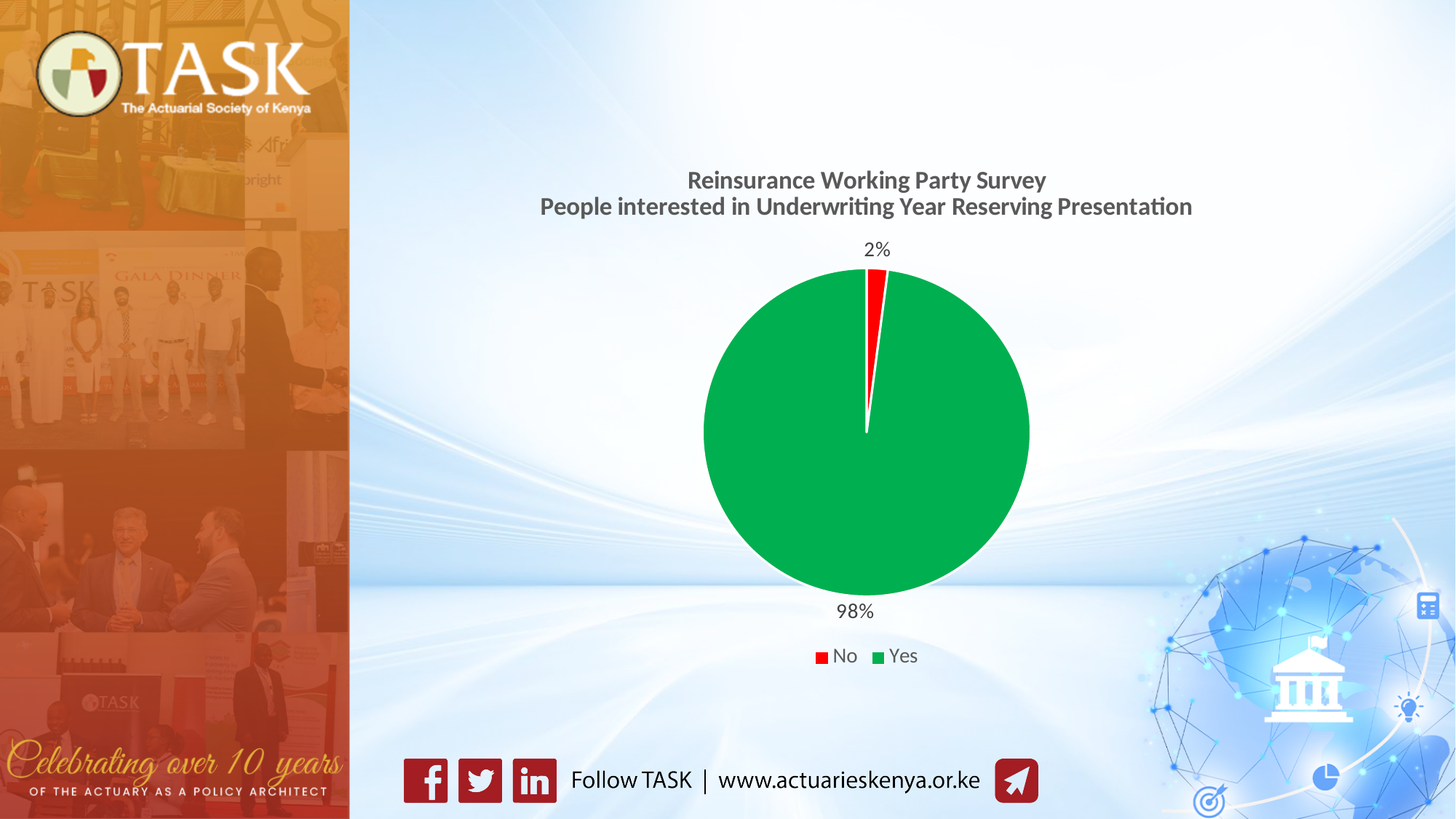
What percentage of respondents answered Yes? 98% What colour is the No slice? red What is the first line of the chart title? Reinsurance Working Party Survey Which is larger, the share for Yes or the share for No? Yes What percentage of respondents answered No? 2% Which response has the smallest share of the pie? No How many slices does the pie chart have? 2 What is the difference in percentage points between the Yes and No shares? 96 How many entries does the legend list? 2 Which response has the largest share of the pie? Yes What kind of chart is shown on the slide? pie chart